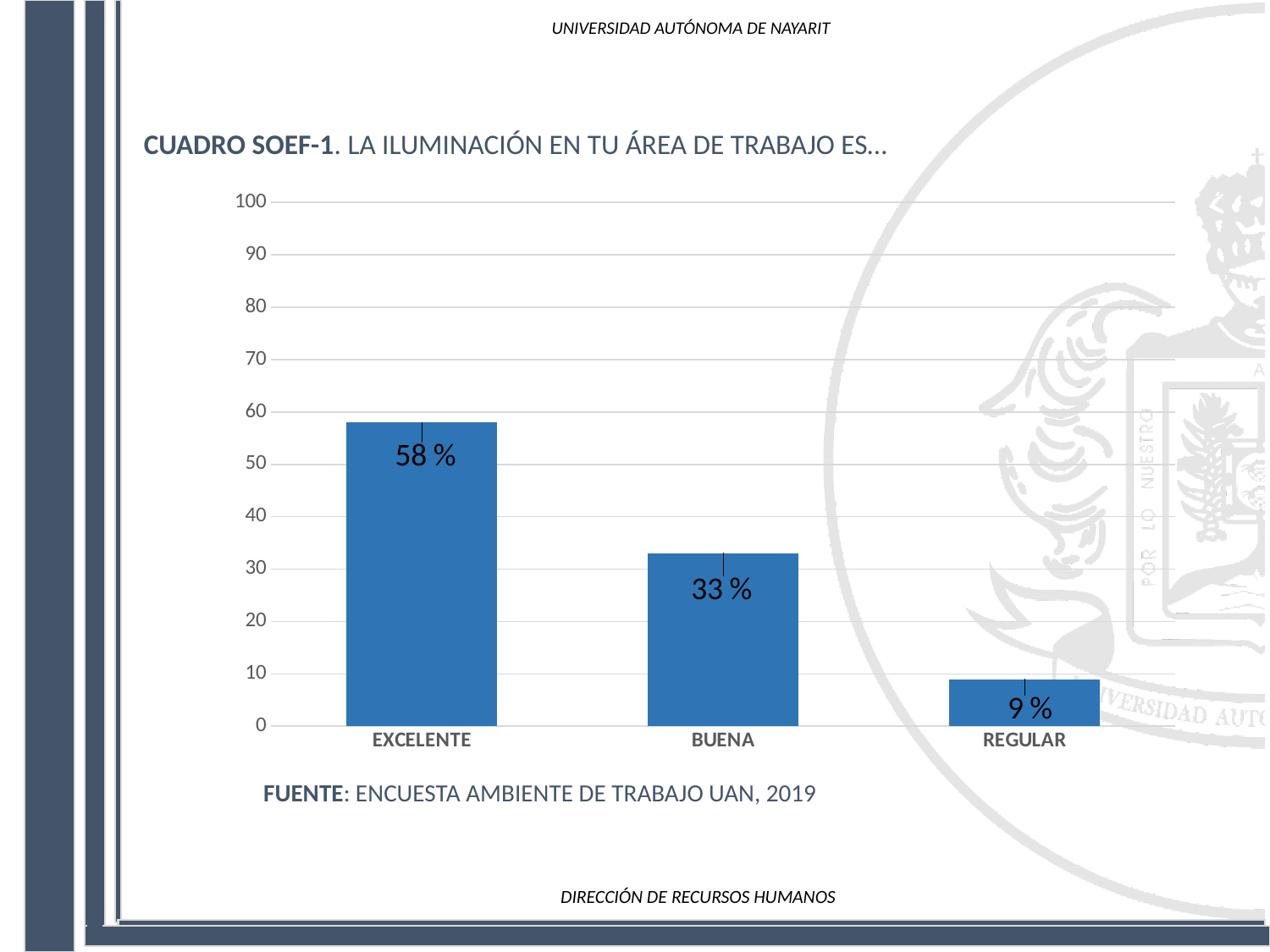
What is the difference between the values for BUENA and REGULAR? 24 % What is the difference between the values for EXCELENTE and BUENA? 25 % What is the value for EXCELENTE? 58 % Which is larger, the value for BUENA or the value for REGULAR? BUENA Is the value for EXCELENTE greater or less than 50? greater Which category has the highest value? EXCELENTE How many categories are shown on the x axis? 3 What kind of chart is shown on the slide? bar chart Do the values rise or fall from left to right along the x axis? fall Which category has the lowest value? REGULAR What is the value for REGULAR? 9 % What is the value for BUENA? 33 %